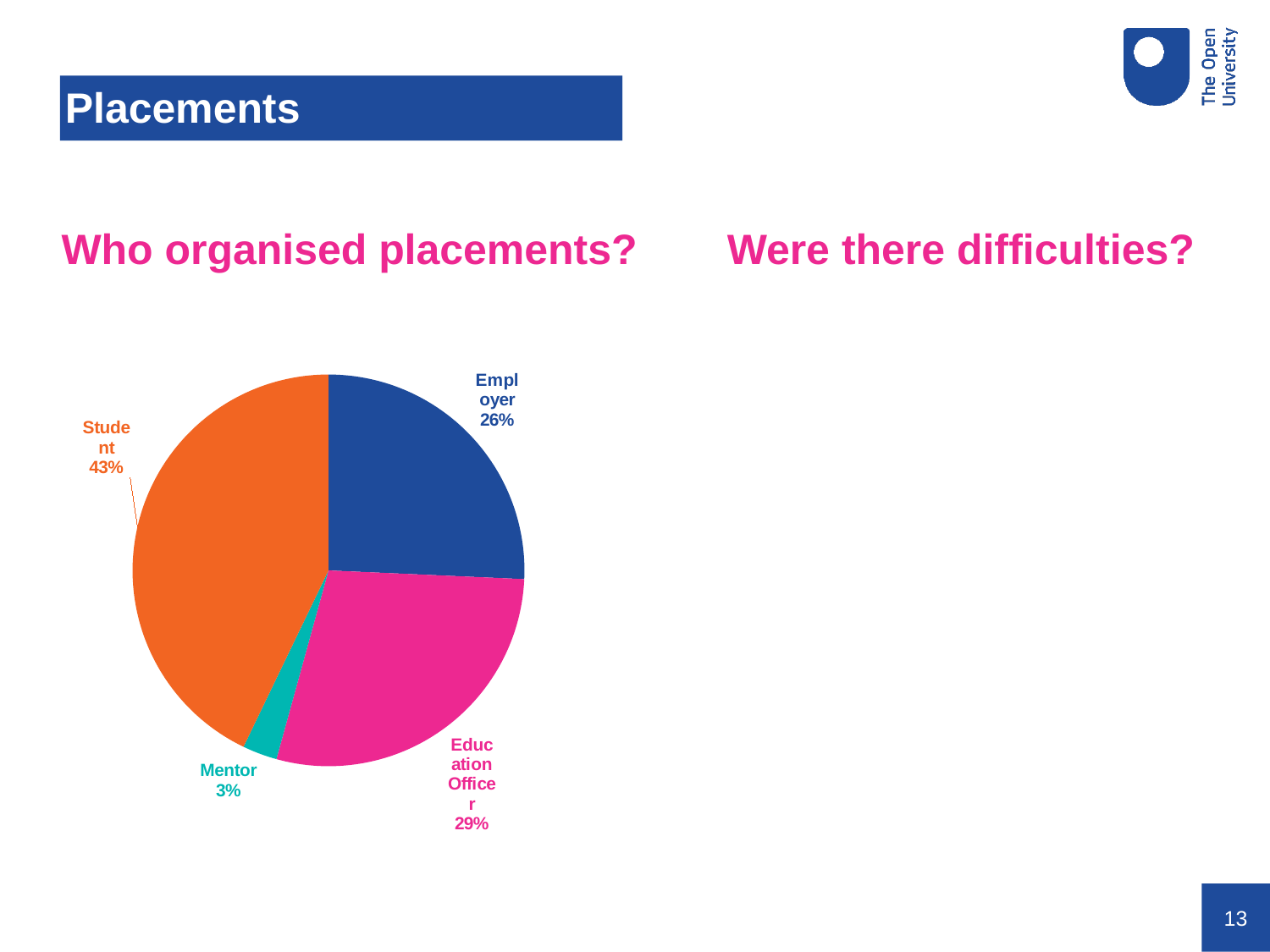
What share of placements were organised by the Mentor? 3% What is the difference in percentage points between the Education Officer and Mentor slices? 26 What share of placements were organised by the Education Officer? 29% What colour is the Student slice of the pie chart? orange Which category has the largest slice of the pie chart? Student What share of placements were organised by the Employer? 26% What is the difference in percentage points between the Student and Employer slices? 17 What kind of chart is shown under "Who organised placements?"? pie chart Which is larger, the Education Officer slice or the Employer slice? Education Officer What share of placements were organised by the Student? 43% Which category has the smallest slice of the pie chart? Mentor How many slices does the pie chart have? 4